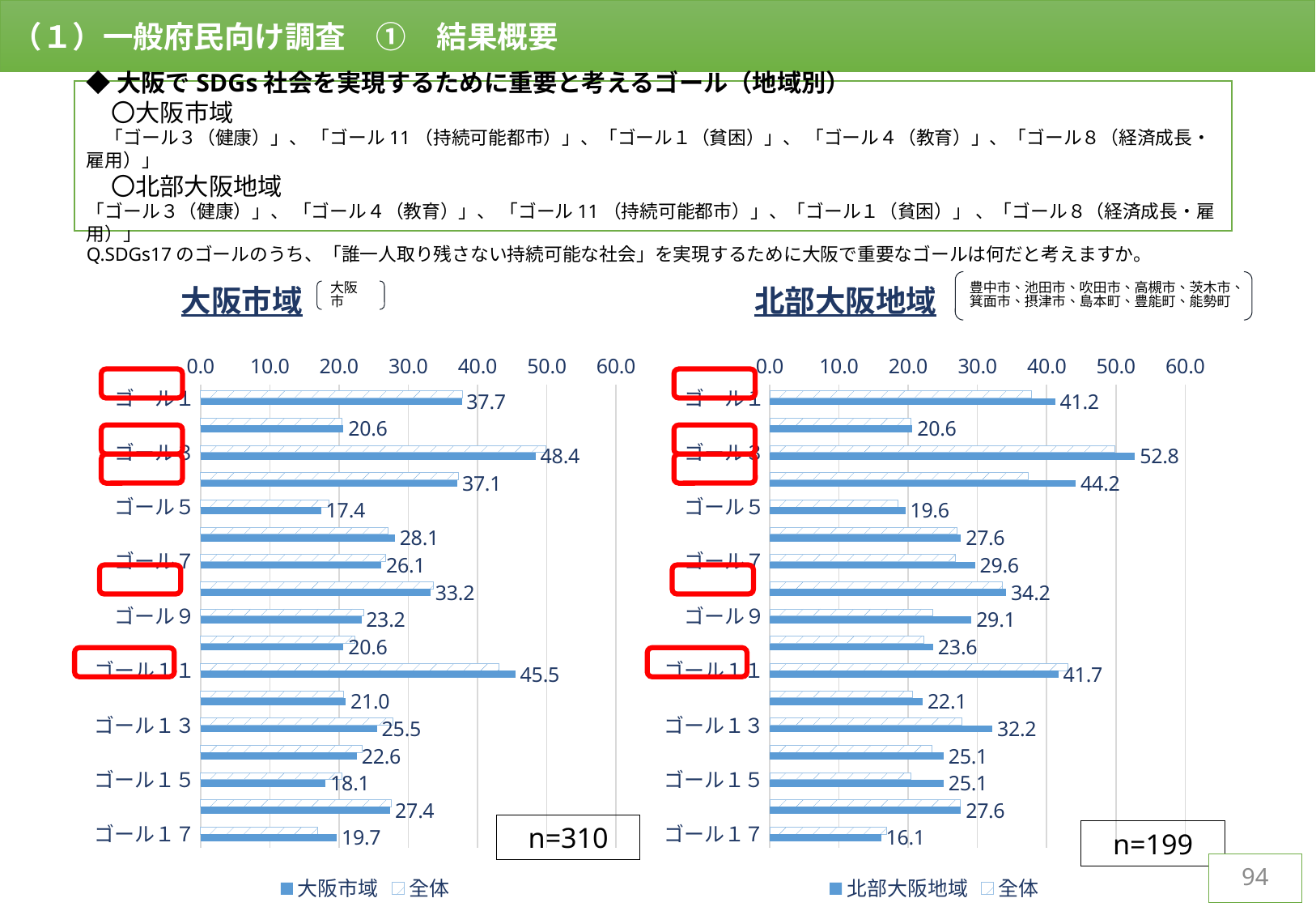
In the 北部大阪地域 chart, what is the value for ゴール11 in the 北部大阪地域 series? 41.7 What type of chart is the 大阪市域 chart? Bar chart How many series does the legend of the 北部大阪地域 chart list? 2 In the 北部大阪地域 chart, which goal has the lowest value in the 北部大阪地域 series? ゴール17 In the 大阪市域 chart, what is the value for ゴール3 in the 大阪市域 series? 48.4 What sample size (n) is shown for the 北部大阪地域 chart? n=199 In the 北部大阪地域 chart, is the 北部大阪地域 value for ゴール13 greater or less than 30.0? greater In the 大阪市域 chart, which goal has the lowest value in the 大阪市域 series? ゴール5 In the 大阪市域 chart, which is larger in the 大阪市域 series: ゴール1 or ゴール11? ゴール11 In the 大阪市域 chart, which goal has the highest value in the 大阪市域 series? ゴール3 In the 北部大阪地域 chart, what is the difference between the 北部大阪地域 values for ゴール3 and ゴール1? 11.6 How many goal categories are plotted in the 大阪市域 chart? 17